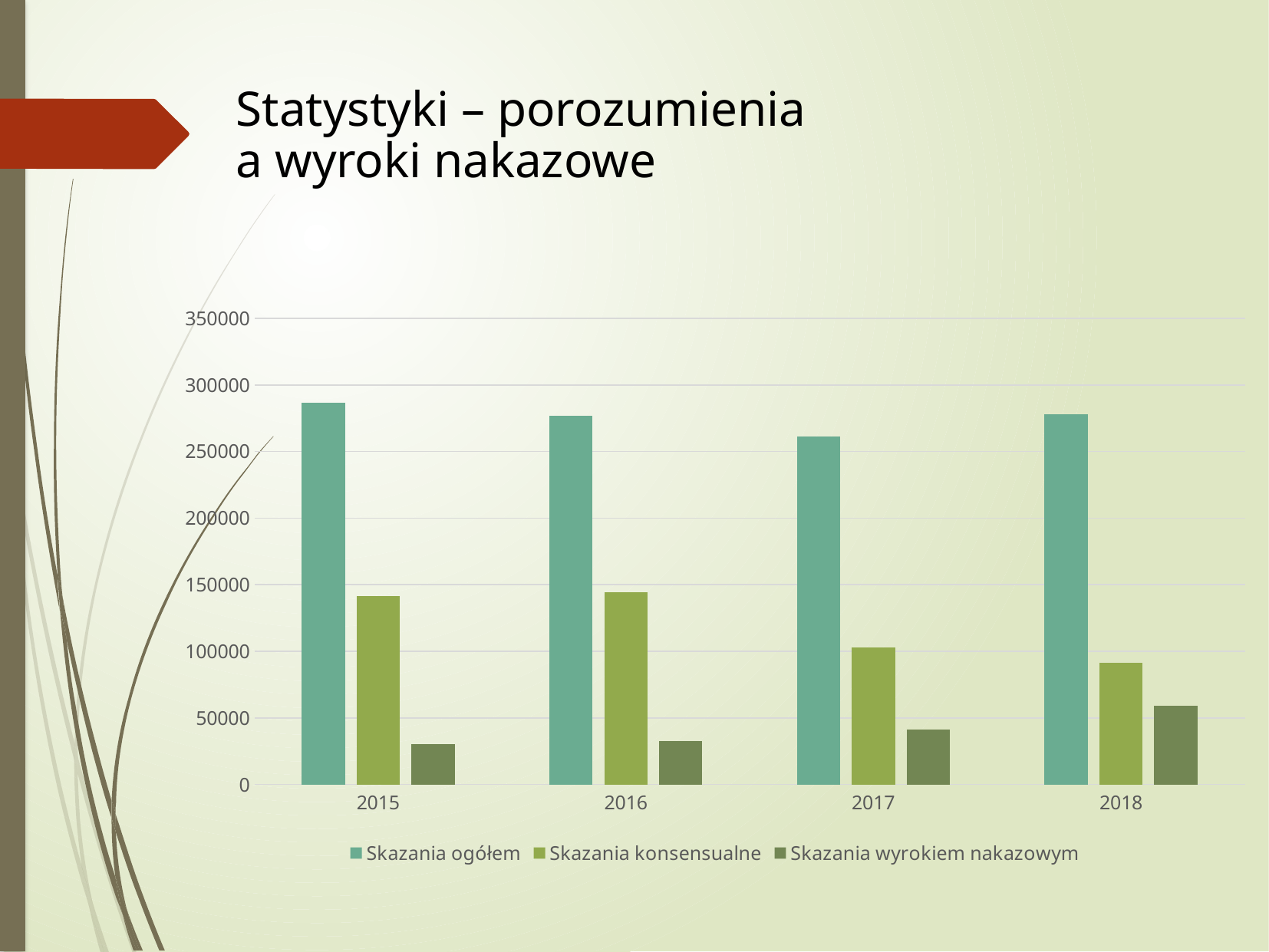
How many series does the legend list? 3 What kind of chart is shown on the slide? bar chart Do the values for Skazania wyrokiem nakazowym rise or fall from 2015 to 2018? rise In which year is the value for Skazania wyrokiem nakazowym highest? 2018 How many years are shown on the x axis? 4 In which year is the value for Skazania ogółem lowest? 2017 Is the value for Skazania wyrokiem nakazowym in 2018 greater or less than 50000? greater Is the value for Skazania konsensualne in 2018 greater or less than 100000? less Which is larger in 2017: Skazania konsensualne or Skazania wyrokiem nakazowym? Skazania konsensualne In which year is the value for Skazania konsensualne lowest? 2018 Is the value for Skazania ogółem in 2015 greater or less than 300000? less In which year is the value for Skazania ogółem highest? 2015